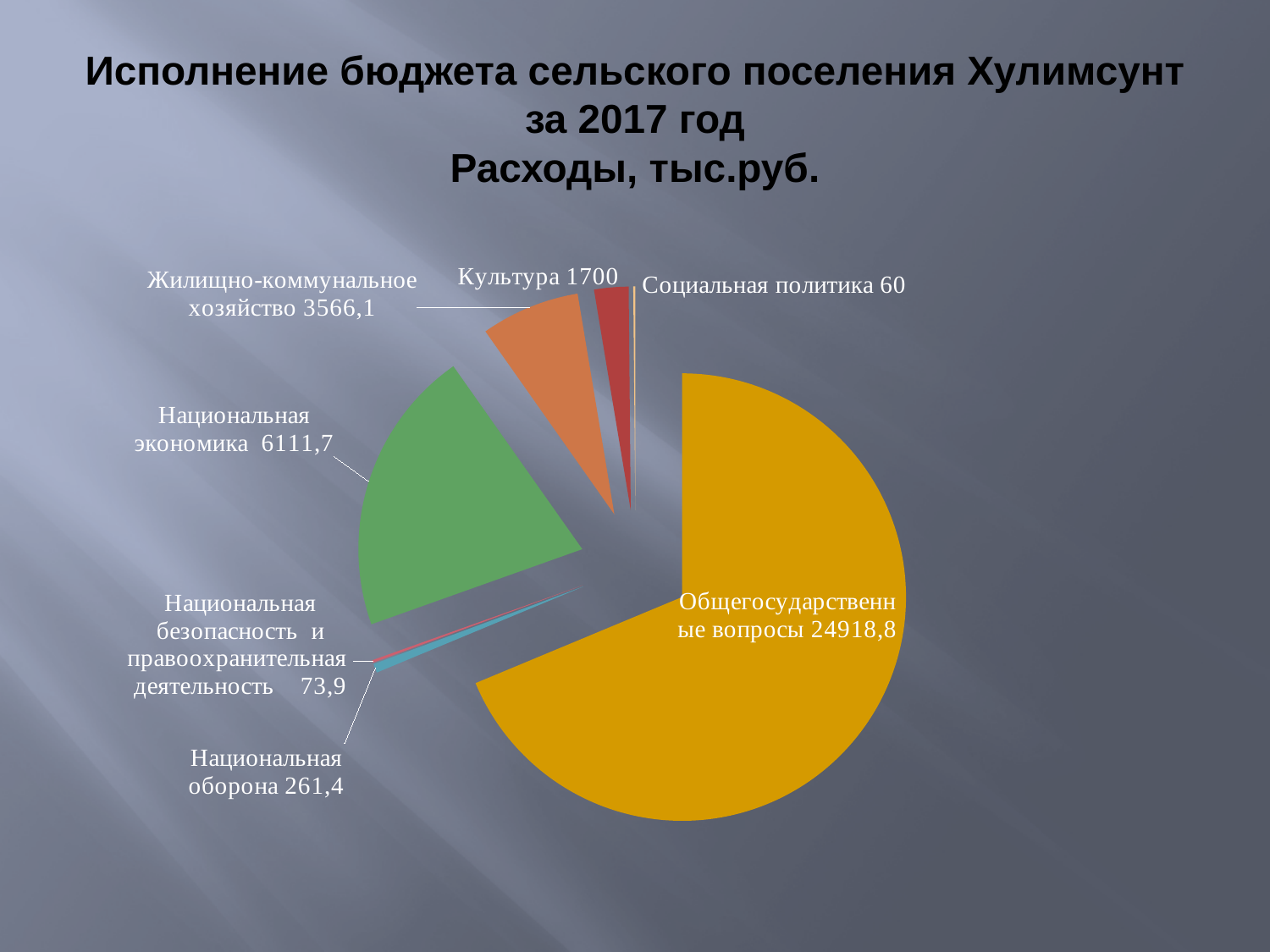
Which category has the smallest value? Социальная политика In what units are the expenditures shown, according to the title? тыс.руб. Which is larger, Национальная экономика or Жилищно-коммунальное хозяйство? Национальная экономика What is the difference between Национальная экономика and Жилищно-коммунальное хозяйство? 2545,6 What is the difference between Культура and Социальная политика? 1640 What kind of chart is shown on the slide? Pie chart How many categories (slices) does the pie chart show? 7 Which category has the largest value? Общегосударственные вопросы What is the value for Национальная оборона? 261,4 What is the value for Общегосударственные вопросы? 24918,8 What is the value for Национальная экономика? 6111,7 What is the value for Жилищно-коммунальное хозяйство? 3566,1